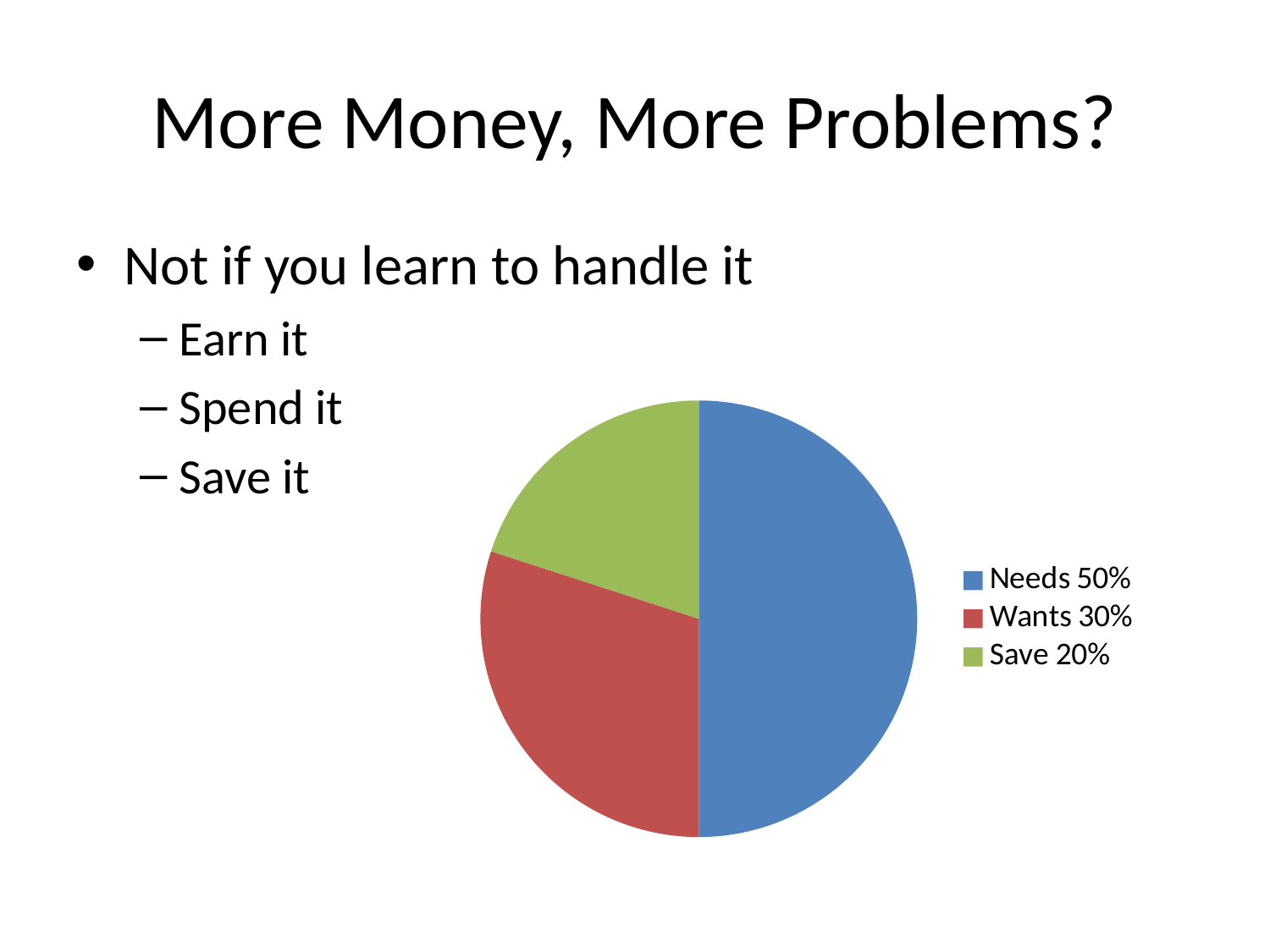
What kind of chart is shown on the slide? pie chart What share of the pie does the Save slice represent? 20% Which is larger, the Wants slice or the Save slice? Wants Which slice of the pie chart is the largest? Needs What share of the pie does the Wants slice represent? 30% How many slices does the pie chart have? 3 What is the difference in percentage points between the Needs slice and the Wants slice? 20 How many entries does the legend of the pie chart list? 3 What is the difference in percentage points between the Wants slice and the Save slice? 10 What share of the pie does the Needs slice represent? 50% What colour is the Needs slice in the pie chart? blue Which slice of the pie chart is the smallest? Save